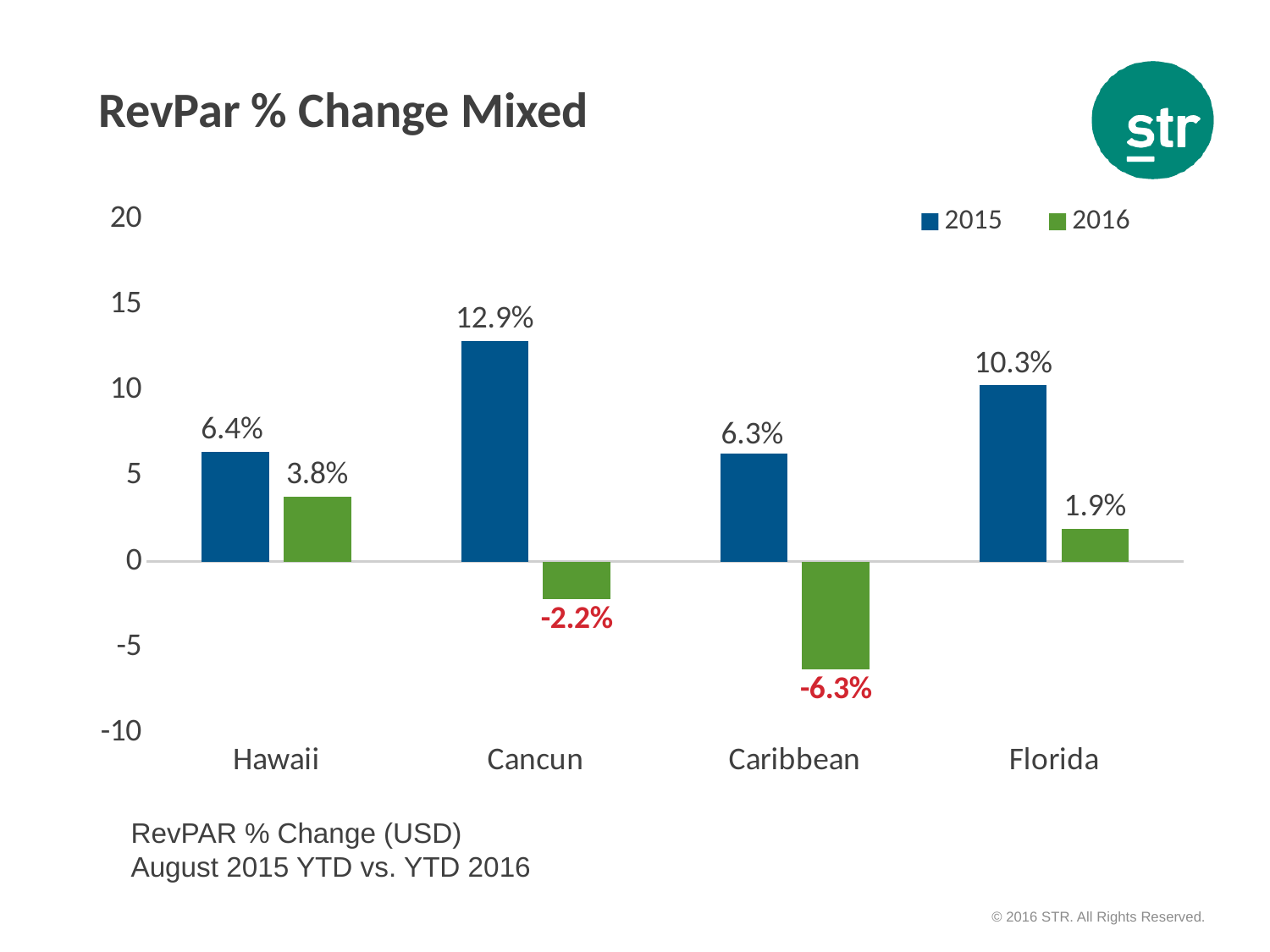
Which is larger, the 2015 value for Florida or the 2015 value for Caribbean? Florida Which market has the highest 2015 value? Cancun Which market has the lowest 2016 value? Caribbean What is the 2015 RevPAR % change for Cancun? 12.9% What is the 2016 RevPAR % change for the Caribbean? -6.3% Is the 2015 value for Cancun greater or less than 10? greater What is the 2016 value for Florida? 1.9% How many series does the legend list? 2 How many markets are shown on the x axis? 4 What kind of chart is shown on the slide? Bar chart What is the difference between the 2015 and 2016 values for Hawaii? 2.6 percentage points Which colour represents the 2016 series? Green